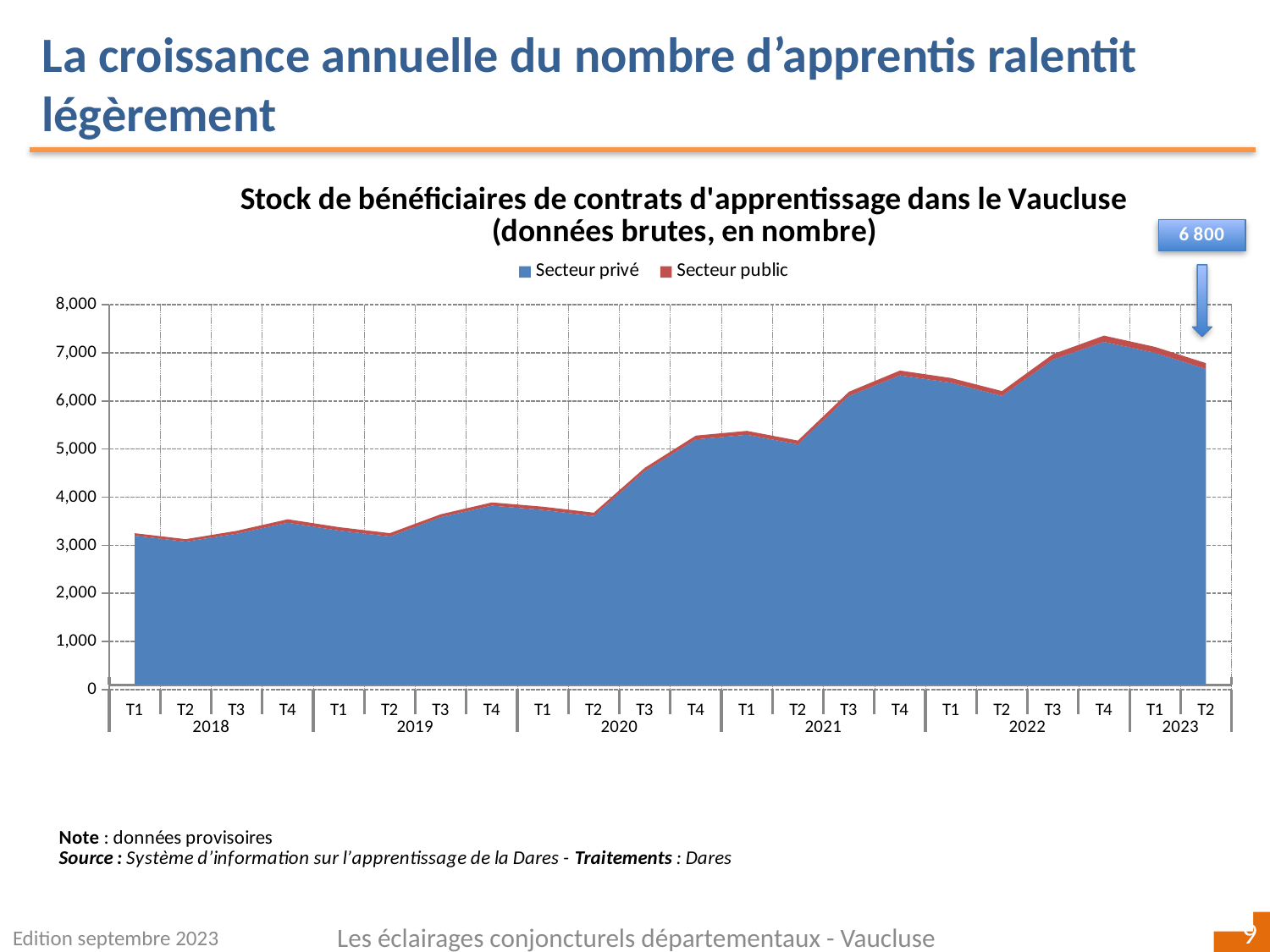
What is the total stock of apprenticeship beneficiaries indicated by the callout for T2 2023? 6 800 Overall, does the total stock of beneficiaries rise or fall from T1 2018 to T2 2023? Rise Which series accounts for the larger share of the stock, Secteur privé or Secteur public? Secteur privé What kind of chart is shown on the slide? Area chart Is the total value for T4 2021 greater or less than 6,000? greater Is the total value for T2 2020 greater or less than 4,000? less Which quarter shows the highest total stock of beneficiaries? T4 2022 How many years are labelled on the x axis? 6 How many series does the legend list? 2 Is the total value for T1 2018 greater or less than 3,000? greater What are the two series named in the legend? Secteur privé and Secteur public